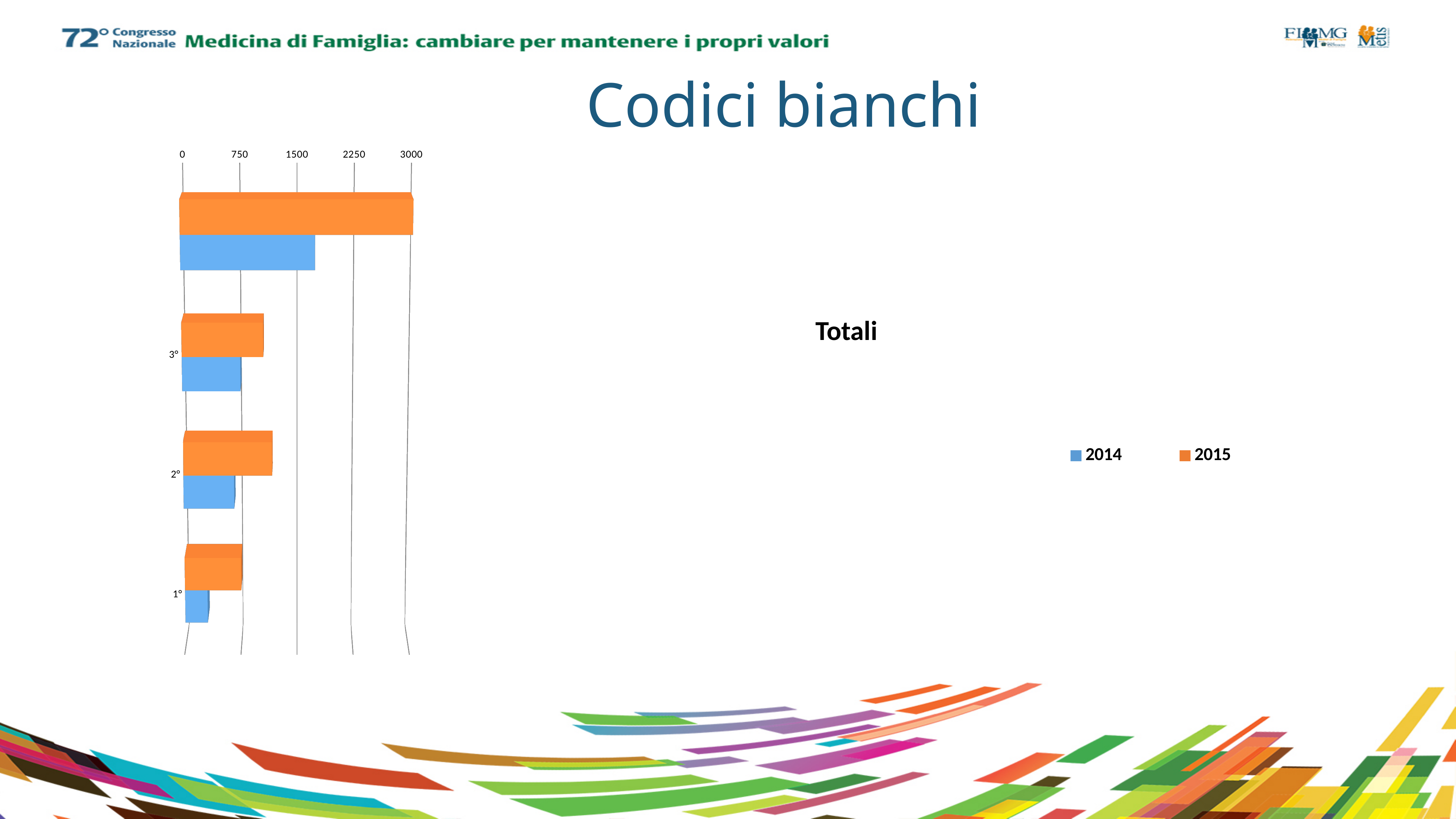
Which two series are listed in the legend? 2014 and 2015 For category 2°, which series has the larger value, 2014 or 2015? 2015 Is the 2015 value for 3° greater or less than 1500? less What kind of chart is shown on the slide? bar chart Is the 2015 value for 2° greater or less than 750? greater Among the categories 1°, 2° and 3°, which has the lowest 2014 value? 1° For category 1°, which series has the larger value, 2014 or 2015? 2015 What colour are the bars for the 2015 series? orange For category 3°, which series has the larger value, 2014 or 2015? 2015 Is the 2014 value for 1° greater or less than 750? less How many series does the legend list? 2